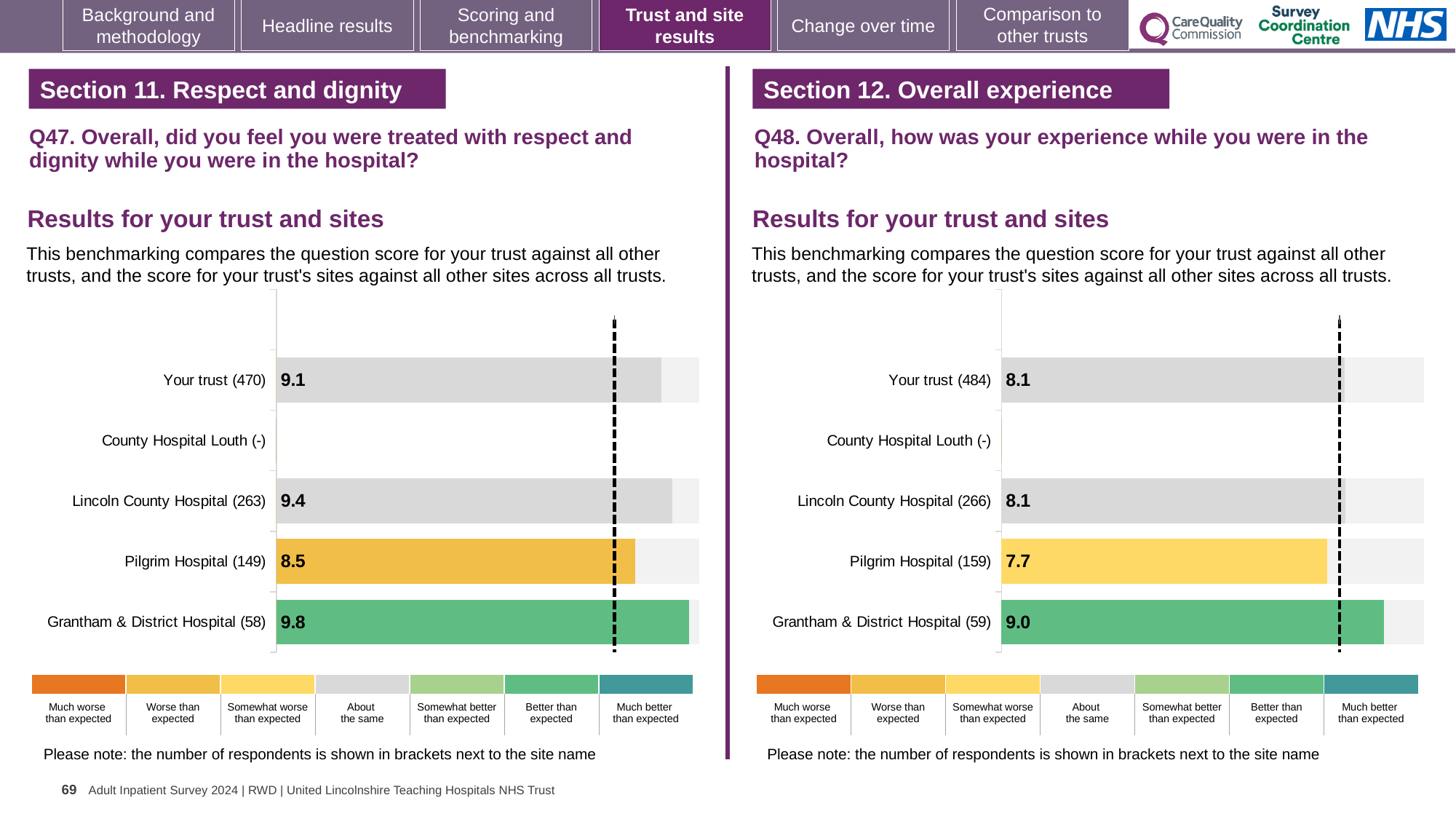
In the Q48 chart on the right, which is larger: the score for Your trust (484) or Grantham & District Hospital (59)? Grantham & District Hospital (59) In the Q47 chart on the left, what is the score for Your trust (470)? 9.1 In the Q48 chart on the right, what is the score for Grantham & District Hospital (59)? 9.0 In the Q48 chart on the right, what is the score for Pilgrim Hospital (159)? 7.7 In the Q47 chart on the left, what is the score for Lincoln County Hospital (263)? 9.4 In the Q48 chart on the right, what is the difference between the scores for Grantham & District Hospital (59) and Your trust (484)? 0.9 In the Q48 chart on the right, which site has the lowest score? Pilgrim Hospital (159) In the Q47 chart on the left, which site has the lowest score? Pilgrim Hospital (149) What kind of chart is the Q48 chart on the right? Bar chart In the Q47 chart on the left, which site has the highest score? Grantham & District Hospital (58) In the Q47 chart on the left, what is the difference between the scores for Grantham & District Hospital (58) and Pilgrim Hospital (149)? 1.3 How many row labels are listed on the vertical axis of the Q47 chart on the left? 5